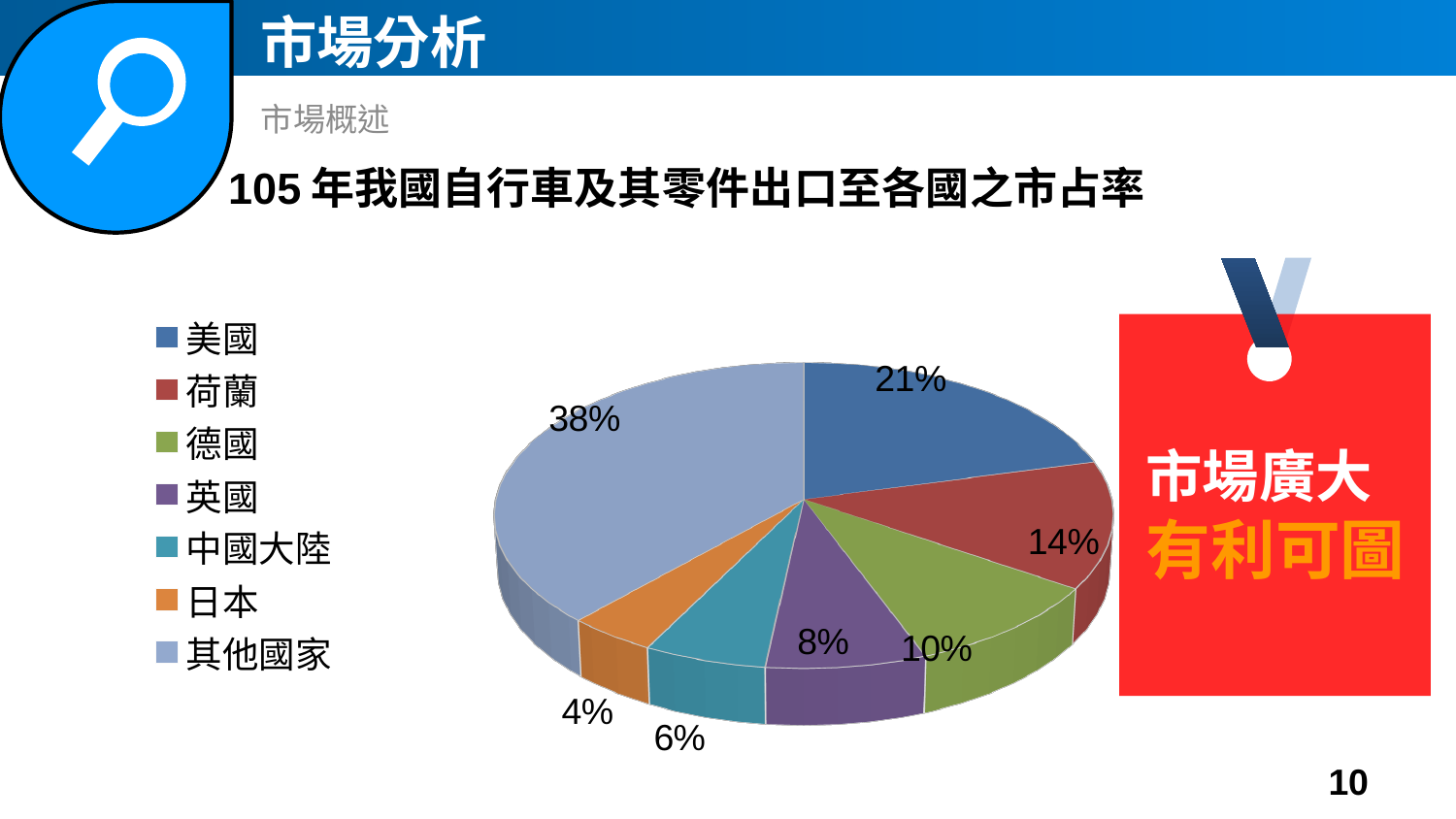
Which category has the largest slice of the pie? 其他國家 What share of the pie does 美國 hold? 21% What is the combined share of 荷蘭 and 德國? 24% How many categories does the pie chart have? 7 Which category has the smallest slice of the pie? 日本 What is the title of the chart on the slide? 105 年我國自行車及其零件出口至各國之市占率 What kind of chart is shown on the slide? Pie chart Which has a larger share, 中國大陸 or 德國? 德國 What share of the pie does 德國 hold? 10% What is the difference between the shares of 美國 and 英國? 13% What share of the pie does 荷蘭 hold? 14% What share of the pie does 日本 hold? 4%